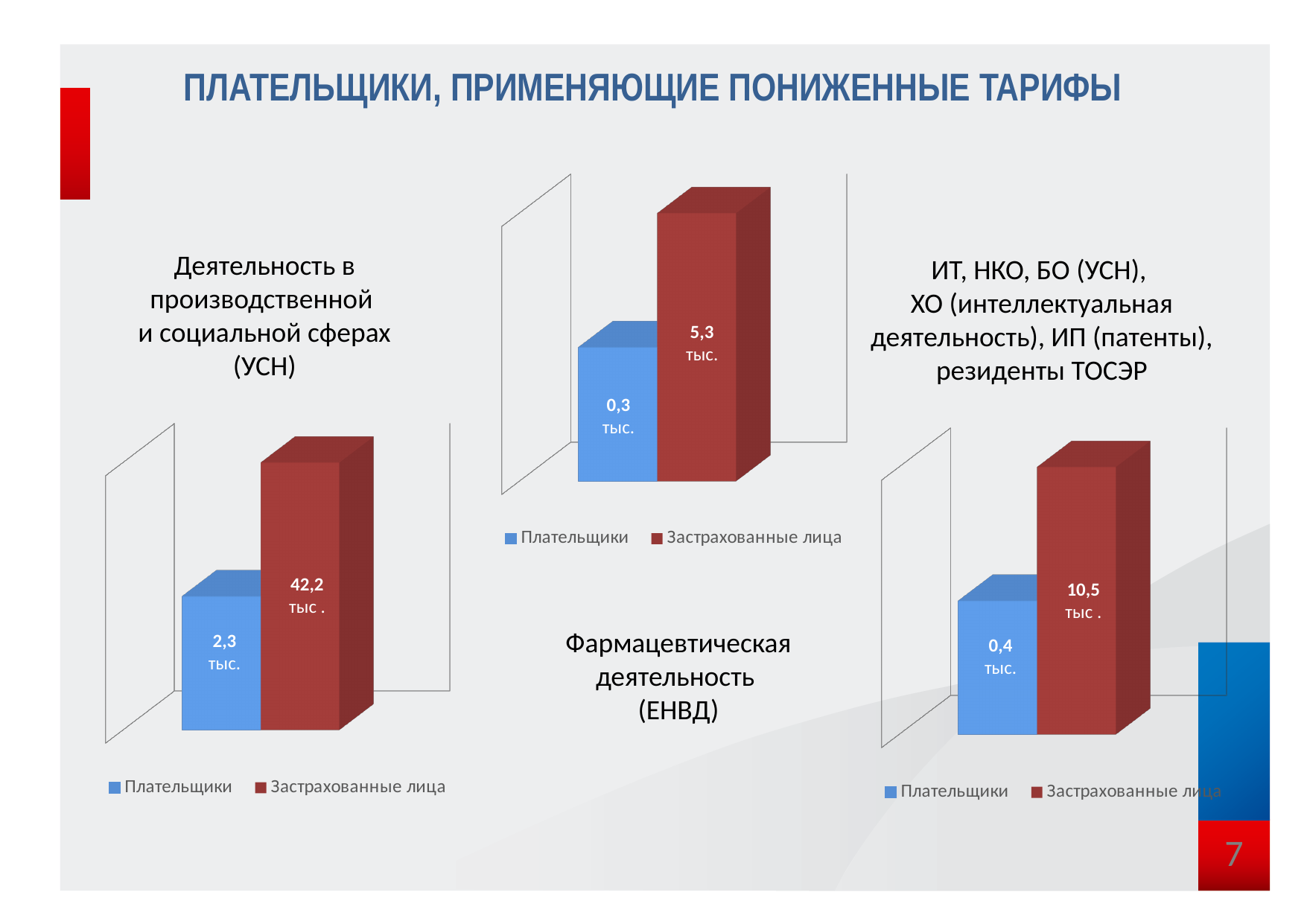
On the left chart, what colour is the bar for Застрахованные лица? Red How many series does the legend of the left chart list? 2 On the left chart (Деятельность в производственной и социальной сферах (УСН)), what is the value for Застрахованные лица? 42,2 тыс. On the right chart, what is the difference between Застрахованные лица and Плательщики? 10,1 тыс. On the left chart (Деятельность в производственной и социальной сферах (УСН)), what is the value for Плательщики? 2,3 тыс. On the right chart (ИТ, НКО, БО (УСН), ХО, ИП (патенты), резиденты ТОСЭР), what is the value for Застрахованные лица? 10,5 тыс. On the top-centre chart (Фармацевтическая деятельность (ЕНВД)), what is the value for Застрахованные лица? 5,3 тыс. On the top-centre chart, which series has the larger value, Плательщики or Застрахованные лица? Застрахованные лица On the top-centre chart (Фармацевтическая деятельность (ЕНВД)), what is the value for Плательщики? 0,3 тыс. On the right chart (ИТ, НКО, БО (УСН), ХО, ИП (патенты), резиденты ТОСЭР), what is the value for Плательщики? 0,4 тыс. What kind of chart is the right chart? Bar chart On the left chart, what is the difference between Застрахованные лица and Плательщики? 39,9 тыс.